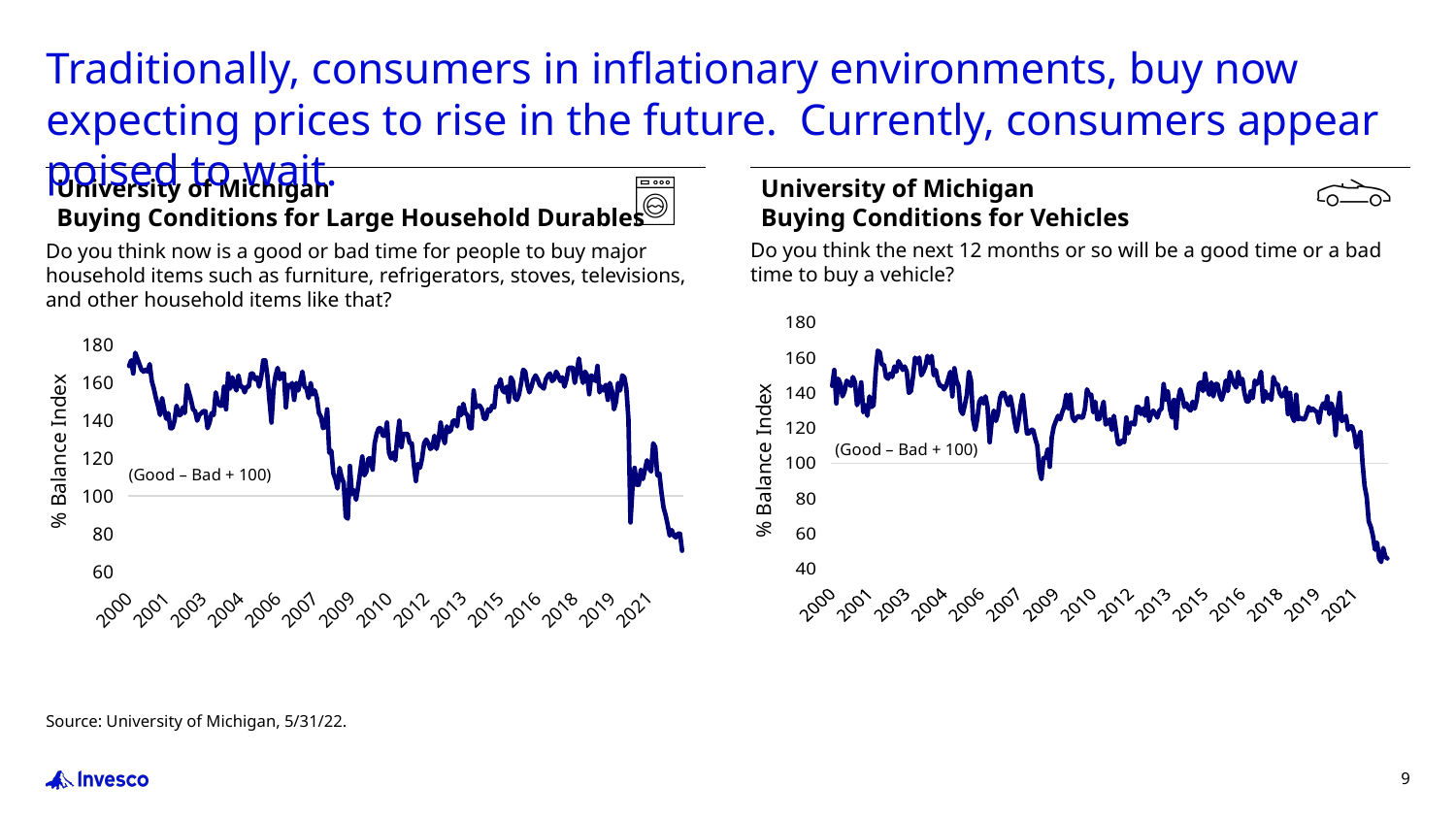
In the left chart (Large Household Durables), does the index overall rise or fall from 2000 to 2021? fall What is the y-axis label on the left chart (Large Household Durables)? % Balance Index How many lines are plotted in the left chart (Large Household Durables)? 1 What formula annotation is printed inside the right chart (Vehicles)? (Good – Bad + 100) What kind of chart is the 'Buying Conditions for Vehicles' chart on the right? line chart In the right chart (Vehicles), is the lowest value around 2009 greater or less than 120? less In the left chart (Large Household Durables), is the value at the start of 2000 greater or less than 140? greater In the left chart (Large Household Durables), is the value at the end of 2021 greater or less than 100? less What kind of chart is the 'Buying Conditions for Large Household Durables' chart on the left? line chart In the right chart (Vehicles), does the index overall rise or fall from 2000 to 2021? fall